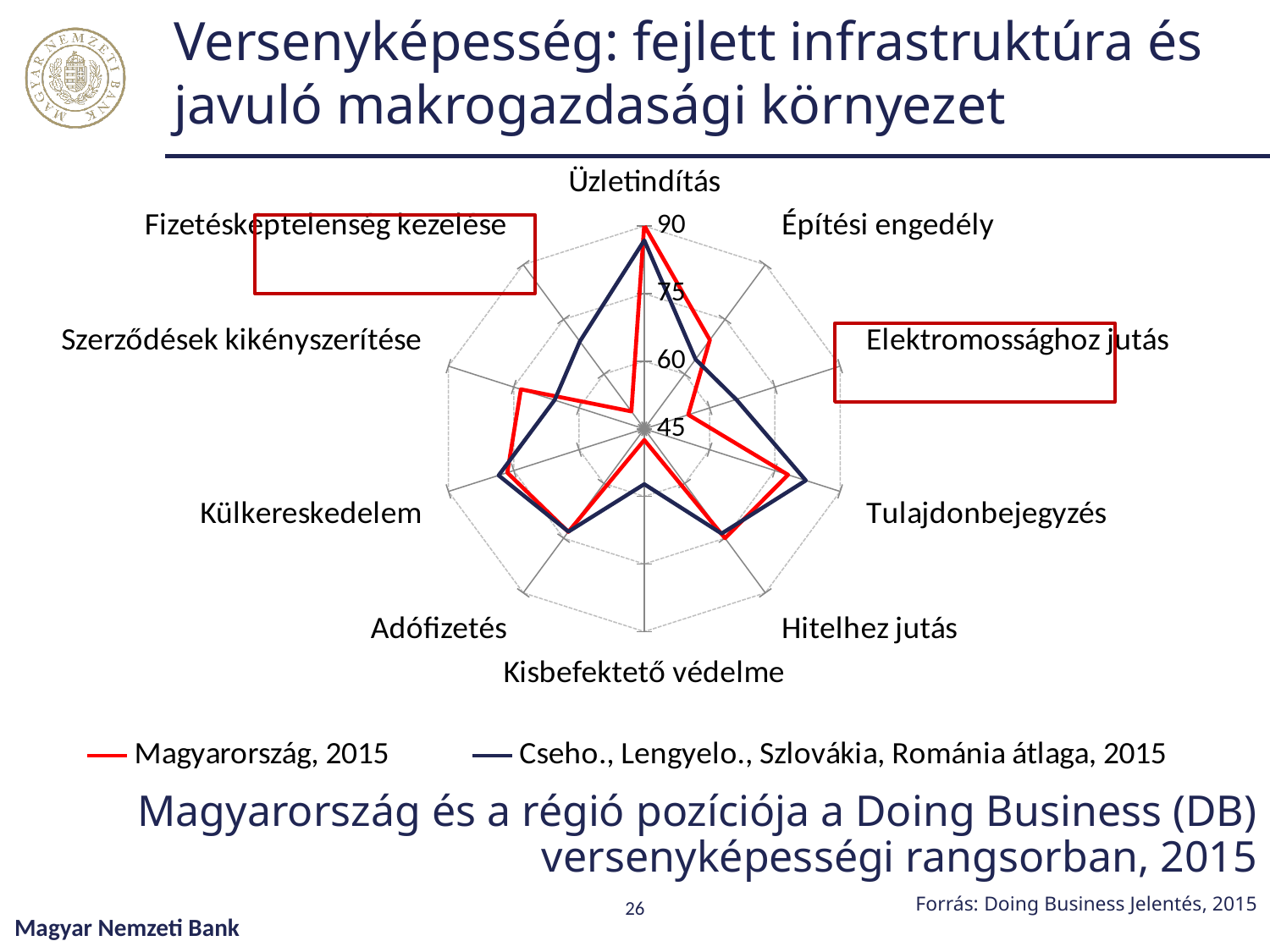
How many series does the legend list? 2 Is the value for Cseho., Lengyelo., Szlovákia, Románia átlaga, 2015 at Tulajdonbejegyzés greater or less than 75? greater What colour is the line for Magyarország, 2015 in the chart? Red At Elektromossághoz jutás, which series has the larger value: Magyarország, 2015 or Cseho., Lengyelo., Szlovákia, Románia átlaga, 2015? Cseho., Lengyelo., Szlovákia, Románia átlaga, 2015 Is the value for Magyarország, 2015 at Fizetésképtelenség kezelése greater or less than 60? less Is the value for Cseho., Lengyelo., Szlovákia, Románia átlaga, 2015 at Fizetésképtelenség kezelése greater or less than 60? greater At Kisbefektető védelme, which series has the larger value: Magyarország, 2015 or Cseho., Lengyelo., Szlovákia, Románia átlaga, 2015? Cseho., Lengyelo., Szlovákia, Románia átlaga, 2015 What kind of chart is shown on the slide? Radar chart How many categories (axes) does the radar chart have? 10 Which category has the highest value for Magyarország, 2015? Üzletindítás